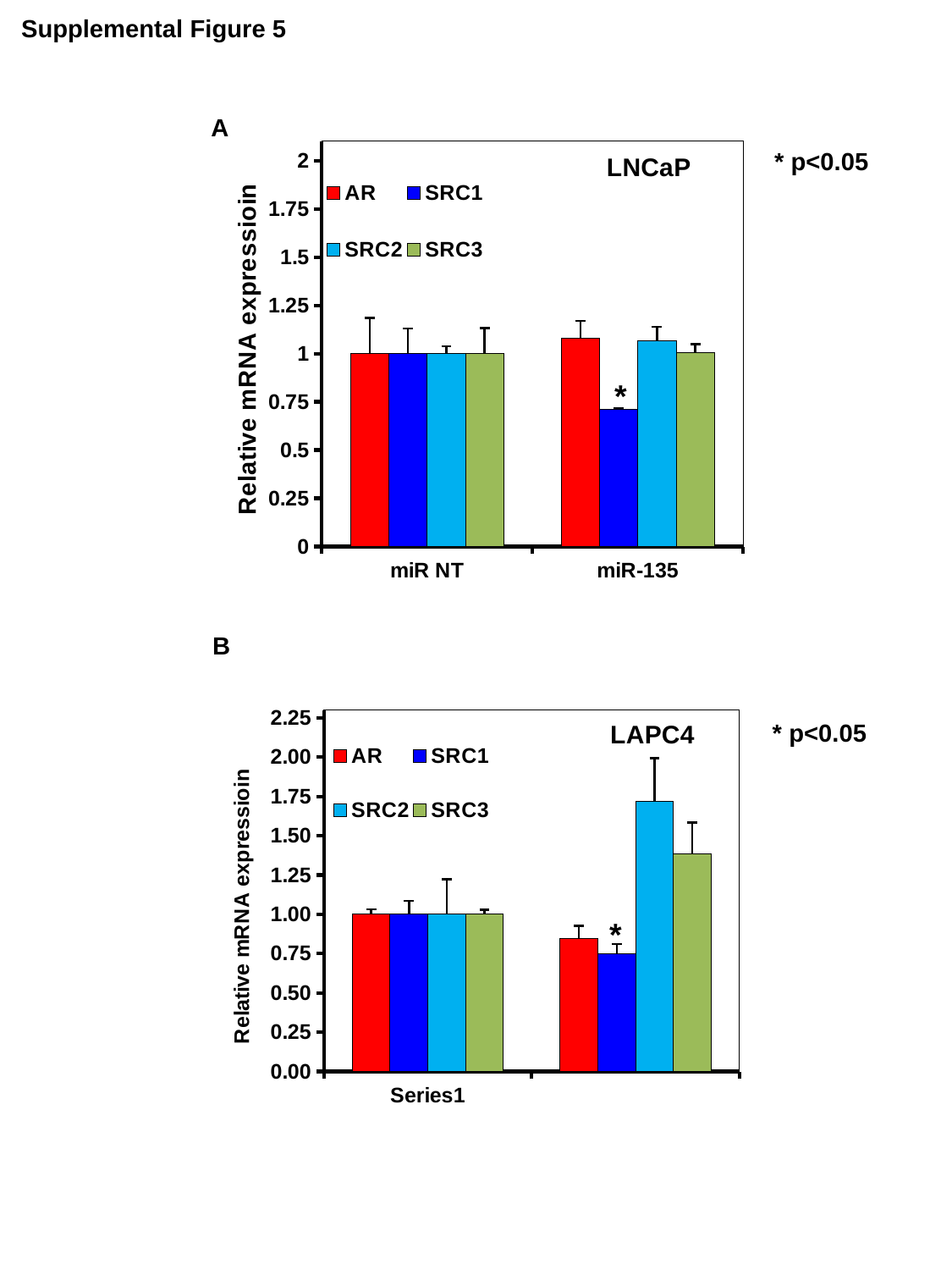
How many series does the legend of the LNCaP chart (panel A) list? 4 In the LNCaP chart (panel A), which is larger in the miR-135 group, SRC2 or SRC1? SRC2 How many categories are shown on the x axis of the LNCaP chart (panel A)? 2 What kind of chart is the LNCaP chart (panel A)? bar chart In the LAPC4 chart (panel B), is the value for SRC2 in the second (right-hand) group greater or less than 1.50? greater In the LNCaP chart (panel A), is the value for SRC1 in the miR-135 group greater or less than 1? less In the LNCaP chart (panel A), is the value for AR in the miR-135 group greater or less than 1? greater In the LAPC4 chart (panel B), which series has the highest value in the second (right-hand) group of bars? SRC2 What is the y-axis label of the LAPC4 chart (panel B)? Relative mRNA expressioin In the LNCaP chart (panel A), which series has the lowest value in the miR-135 group? SRC1 How many series does the legend of the LAPC4 chart (panel B) list? 4